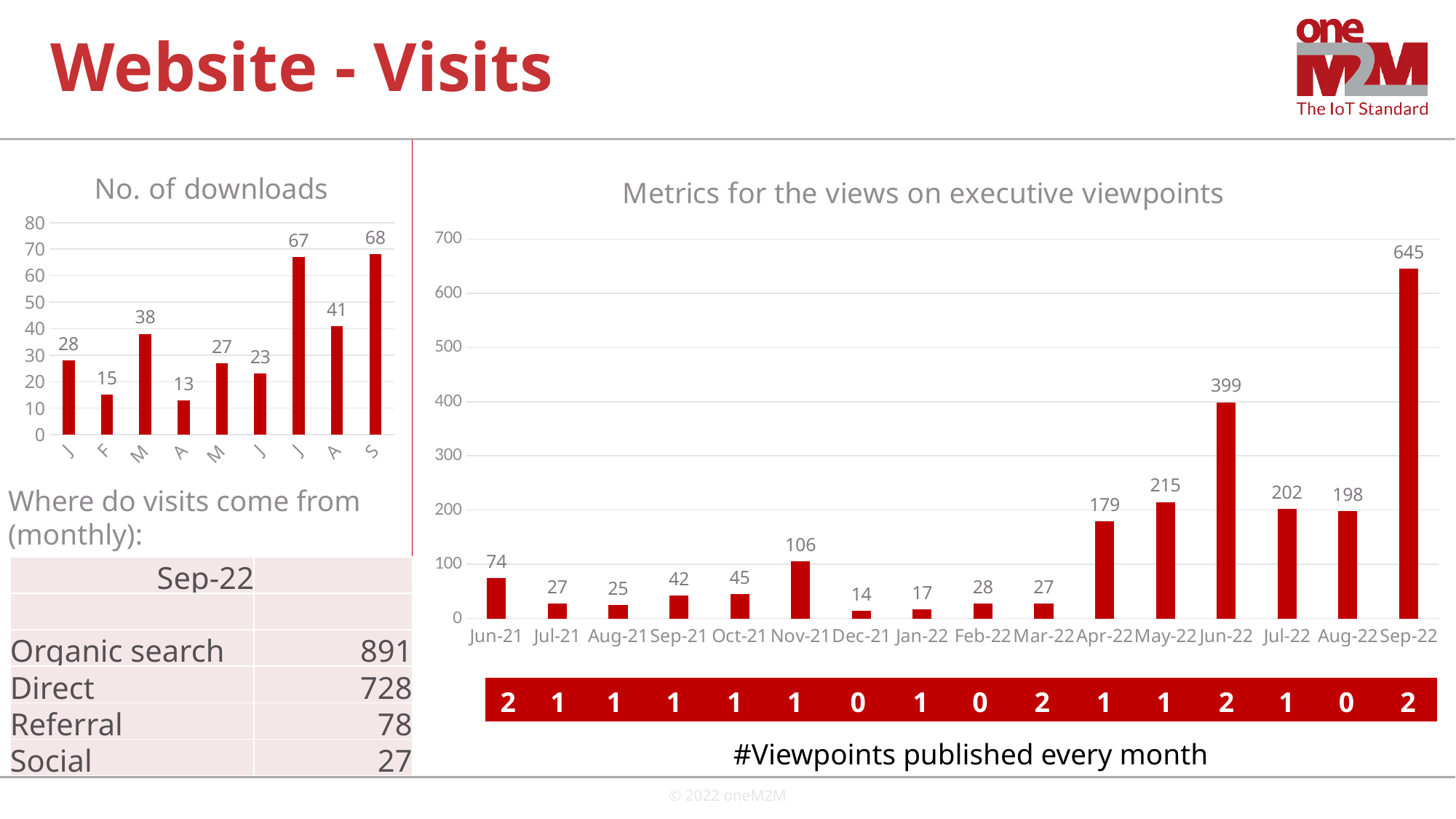
In the 'Metrics for the views on executive viewpoints' chart, what is the value for Nov-21? 106 In the 'Metrics for the views on executive viewpoints' chart, what is the value for Sep-22? 645 In the 'Metrics for the views on executive viewpoints' chart, which month has the lowest value? Dec-21 In the 'No. of downloads' chart, what is the value for the last month, labelled S? 68 What kind of chart is 'Metrics for the views on executive viewpoints'? Bar chart In the 'Metrics for the views on executive viewpoints' chart, which is larger, the value for Jul-22 or Aug-22? Jul-22 In the 'No. of downloads' chart, what is the value for the month labelled F? 15 How many months are shown on the x axis of the 'Metrics for the views on executive viewpoints' chart? 16 In the 'Metrics for the views on executive viewpoints' chart, what is the difference between the values for Sep-22 and Jun-22? 246 In the 'No. of downloads' chart, what is the lowest value shown? 13 How many bars are in the 'No. of downloads' chart? 9 In the 'Metrics for the views on executive viewpoints' chart, which month has the highest value? Sep-22